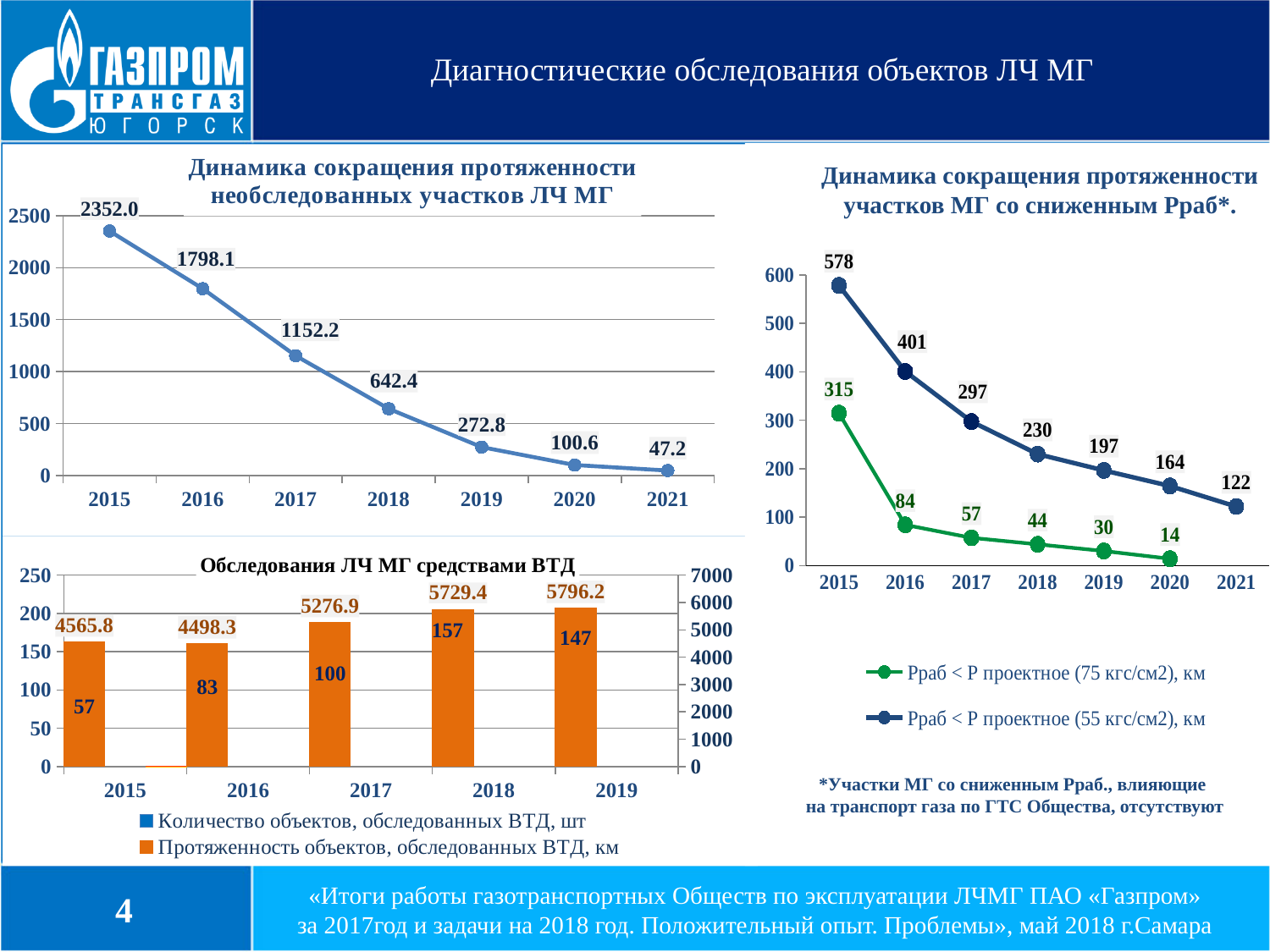
How many years are plotted in the chart 'Динамика сокращения протяженности необследованных участков ЛЧ МГ'? 7 In the chart 'Обследования ЛЧ МГ средствами ВТД', how many series does the legend list? 2 In the chart 'Обследования ЛЧ МГ средствами ВТД', what is the 'Протяженность объектов, обследованных ВТД, км' value for 2019? 5796.2 In the chart 'Динамика сокращения протяженности участков МГ со сниженным Рраб*', what is the value of the 'Рраб < Р проектное (55 кгс/см2), км' series for 2017? 297 In the chart 'Обследования ЛЧ МГ средствами ВТД', what is the difference between the 'Количество объектов' values for 2018 and 2019? 10 What type of chart is 'Динамика сокращения протяженности участков МГ со сниженным Рраб*'? line chart In the chart 'Обследования ЛЧ МГ средствами ВТД', which year has the highest 'Количество объектов, обследованных ВТД, шт'? 2018 In the chart 'Динамика сокращения протяженности необследованных участков ЛЧ МГ', what is the value for 2021? 47.2 In the chart 'Динамика сокращения протяженности необследованных участков ЛЧ МГ', what is the value for 2015? 2352.0 In the chart 'Динамика сокращения протяженности участков МГ со сниженным Рраб*', which series has the larger value in 2016: 75 кгс/см2 or 55 кгс/см2? Рраб < Р проектное (55 кгс/см2), км In the chart 'Динамика сокращения протяженности необследованных участков ЛЧ МГ', what is the difference between the 2017 and 2018 values? 509.8 In the chart 'Динамика сокращения протяженности необследованных участков ЛЧ МГ', do the values rise or fall from 2015 to 2021? fall